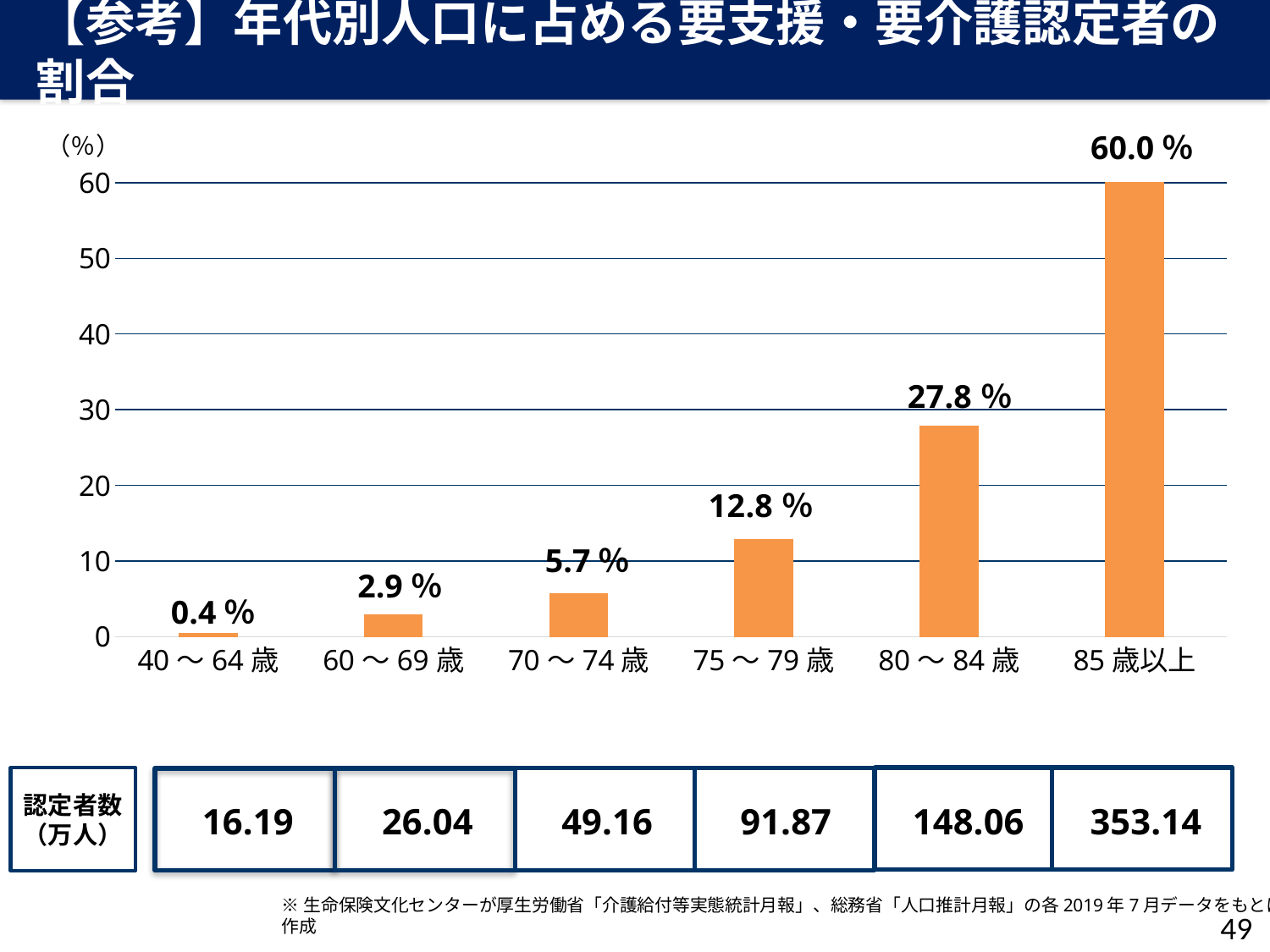
What is the difference between the values for 85歳以上 and 80～84歳? 32.2 % Which age group has the lowest value? 40～64歳 What is the value for 40～64歳? 0.4 % What is the value for 75～79歳? 12.8 % Do the values rise or fall from left to right along the x axis? rise How many age groups are shown on the x axis? 6 Is the value for 80～84歳 greater or less than 30? less What kind of chart is shown on the slide? bar chart What is the difference between the values for 75～79歳 and 70～74歳? 7.1 % Which is larger, the value for 60～69歳 or the value for 70～74歳? 70～74歳 What is the value for 85歳以上? 60.0 % Which age group has the highest value? 85歳以上